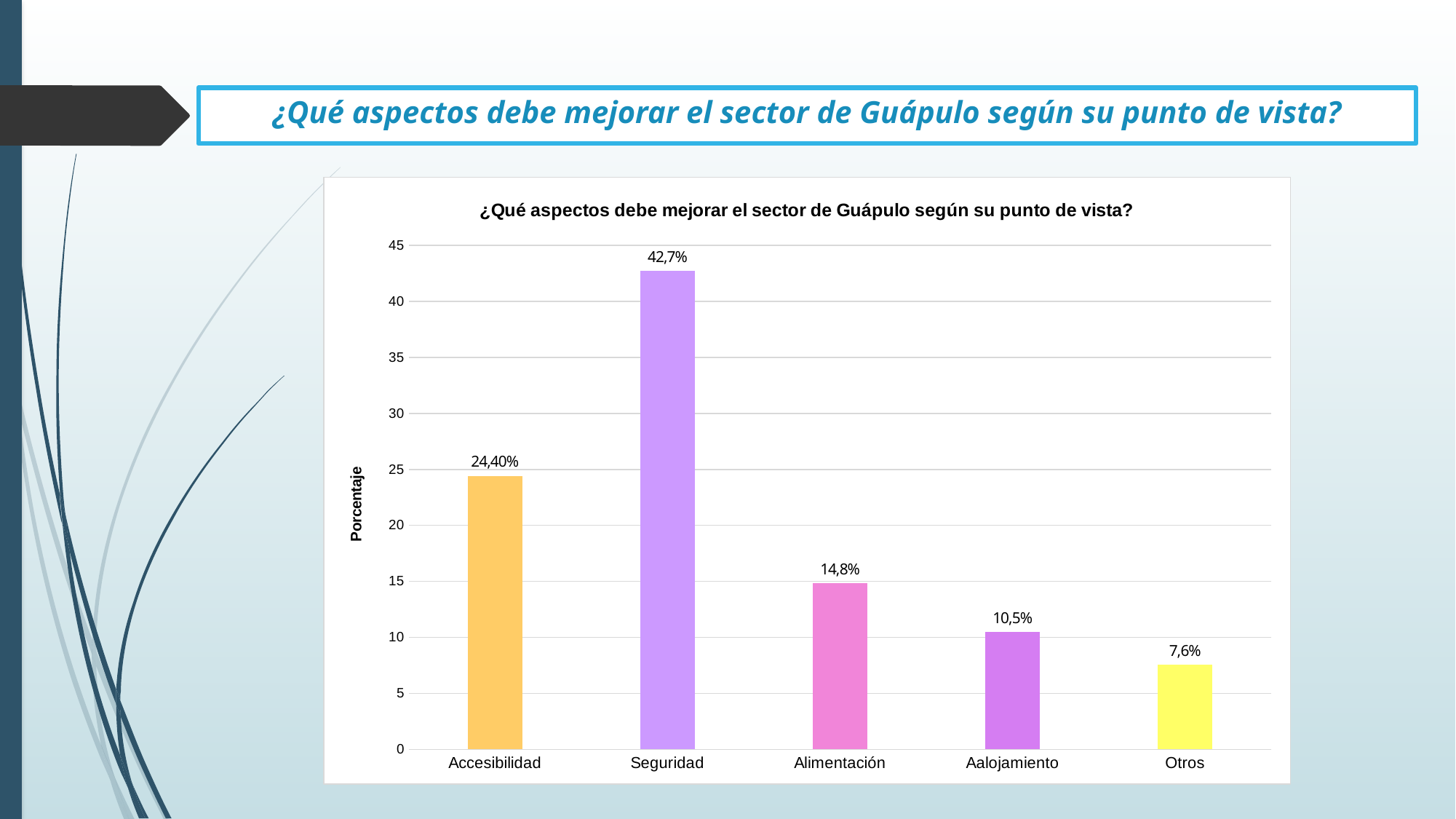
How many categories are shown on the x axis? 5 What is the value for Alimentación? 14,8% Which category has the lowest value? Otros What is the value for Otros? 7,6% What is the difference between the values for Seguridad and Accesibilidad? 18,3% Is the value for Aalojamiento greater or less than 15? less What kind of chart is shown on the slide? bar chart What is the value for Seguridad? 42,7% Which is larger, the value for Alimentación or the value for Aalojamiento? Alimentación What is the label of the vertical axis? Porcentaje Which category has the highest value? Seguridad What is the value for Accesibilidad? 24,40%